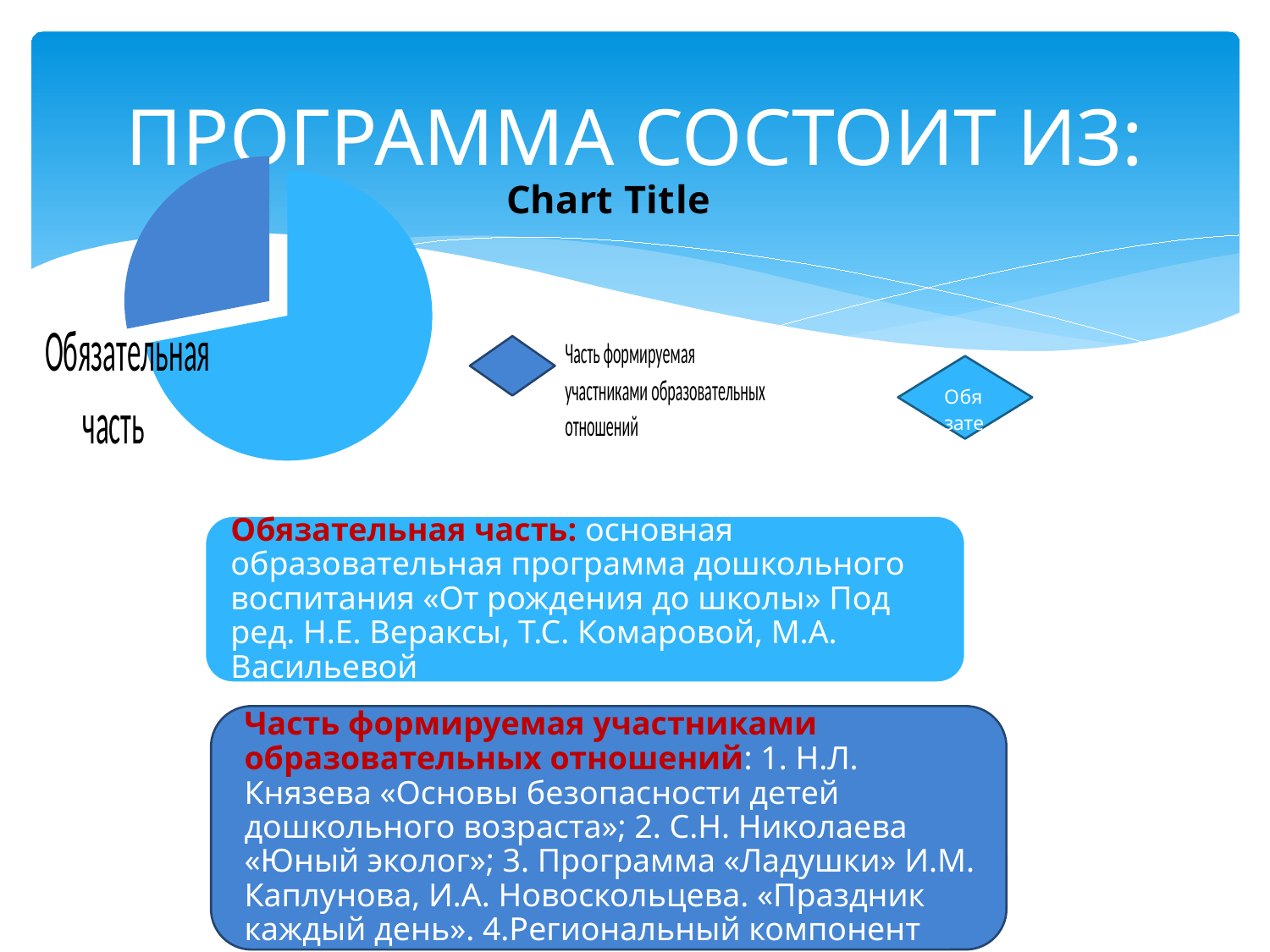
Which slice of the pie chart is the smallest? Часть формируемая участниками образовательных отношений How many slices does the pie chart have? 2 What kind of chart is shown on the slide? pie chart Which slice is larger: Обязательная часть or Часть формируемая участниками образовательных отношений? Обязательная часть Which slice of the pie chart is the largest? Обязательная часть What is the title printed above the pie chart? Chart Title Which slice of the pie chart is pulled out (exploded) from the rest of the pie? Часть формируемая участниками образовательных отношений